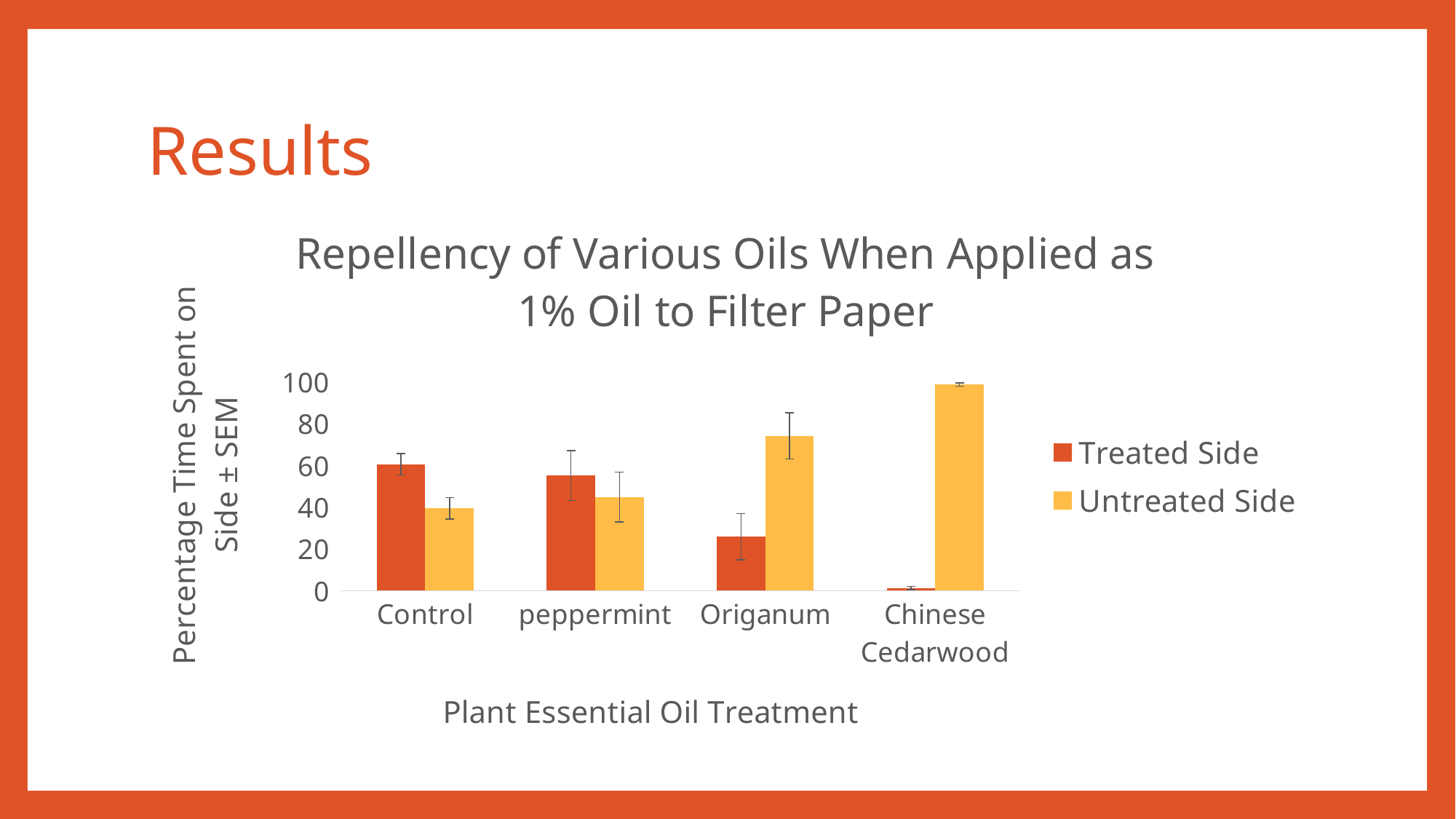
For Control, which is larger: the Treated Side or the Untreated Side value? Treated Side Is the Treated Side value for Origanum greater or less than 40? less What kind of chart is shown on the slide? bar chart How many treatment categories are shown on the x axis? 4 What is the title of the chart? Repellency of Various Oils When Applied as 1% Oil to Filter Paper Is the Untreated Side value for Chinese Cedarwood greater or less than 80? greater Which treatment has the lowest Treated Side value? Chinese Cedarwood Which treatment has the highest Untreated Side value? Chinese Cedarwood Is the Untreated Side value for Origanum greater or less than 60? greater What is the x-axis title of the chart? Plant Essential Oil Treatment For Origanum, which is larger: the Treated Side or the Untreated Side value? Untreated Side How many series does the legend list? 2